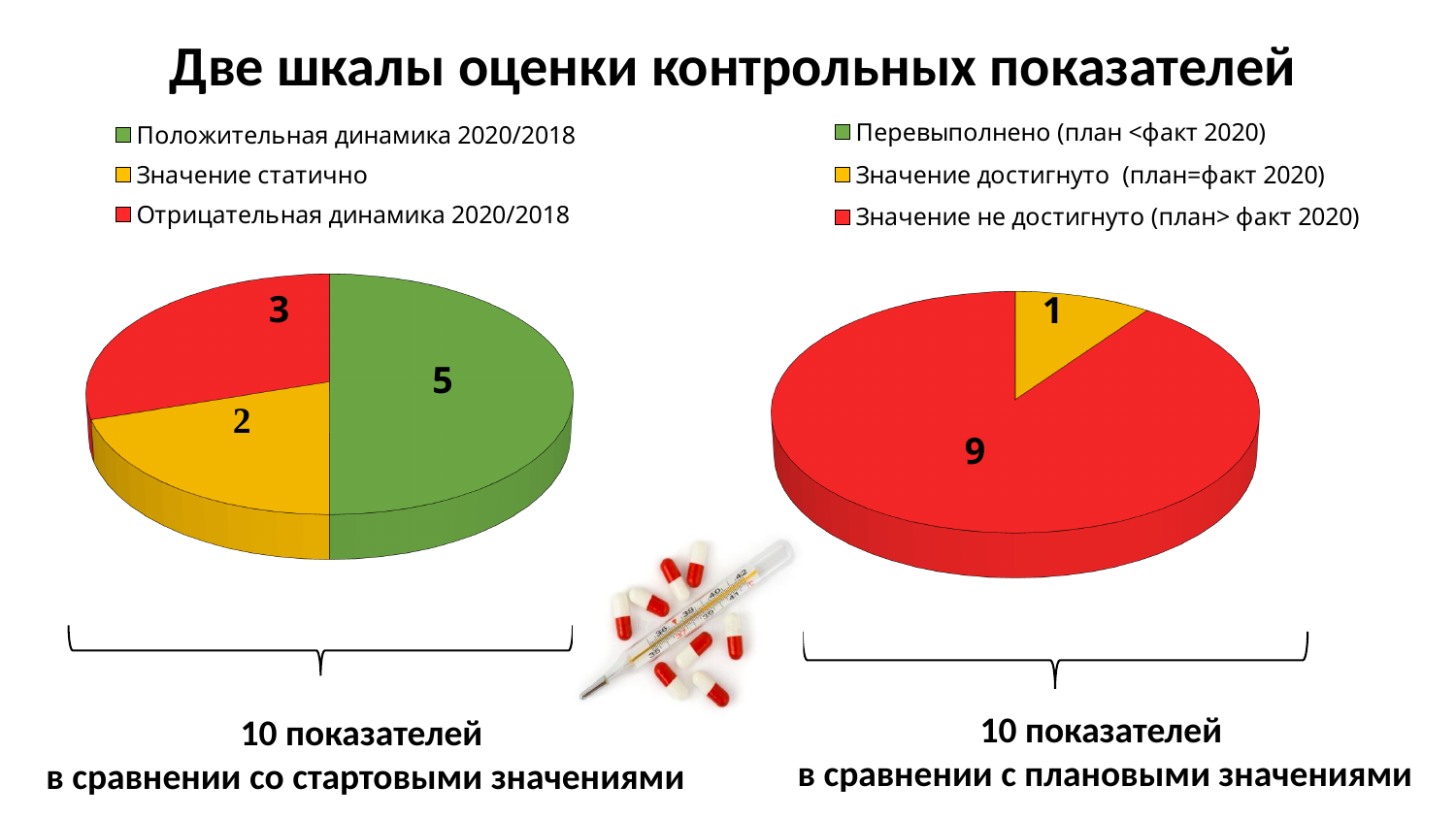
In the right pie chart, what is the value for 'Значение достигнуто (план=факт 2020)'? 1 What colour represents 'Перевыполнено (план <факт 2020)' in the right chart's legend? Green In the right pie chart, what is the value for 'Значение не достигнуто (план> факт 2020)'? 9 In the left pie chart, how many indicators show positive dynamics 2020/2018 (Положительная динамика 2020/2018)? 5 In the left pie chart, what is the value for 'Отрицательная динамика 2020/2018'? 3 In the left pie chart, what is the value for 'Значение статично'? 2 What type of chart is used on the left side of the slide? Pie chart How many legend entries does the right chart list? 3 In the left pie chart, which category has the largest slice? Положительная динамика 2020/2018 In the right pie chart, what share of the total do the 'Значение не достигнуто' indicators represent? 90% In the left pie chart, which category has the smallest slice? Значение статично In the left pie chart, what is the difference between the positive dynamics value and the negative dynamics value? 2